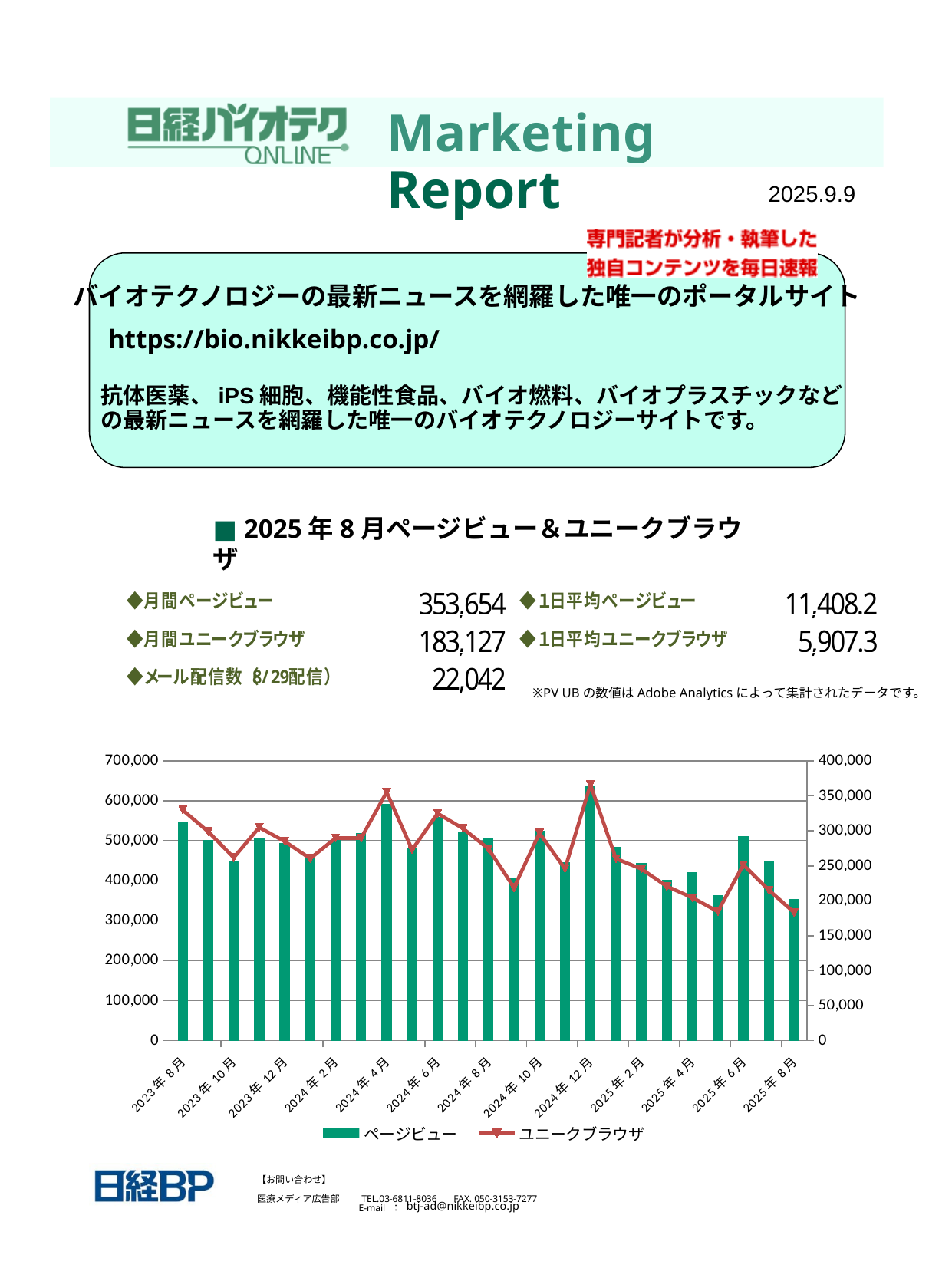
Is the ユニークブラウザ value for 2025年8月 greater or less than 200,000 on the right axis? less Do the ページビュー bars generally rise or fall from 2024年12月 to 2025年5月? fall How many monthly bars are plotted in the chart? 25 Which month has the highest ページビュー bar? 2024年12月 What is the maximum value shown on the left vertical axis? 700,000 Which month has the larger ページビュー bar, 2024年4月 or 2023年10月? 2024年4月 How many series does the chart legend list? 2 Which month has the highest point on the ユニークブラウザ line? 2024年12月 Is the ページビュー bar for 2025年8月 greater or less than 400,000? less What are the two series named in the chart legend? ページビュー and ユニークブラウザ Is the ページビュー bar for 2024年12月 greater or less than 600,000? greater What kind of chart is shown on the slide? A combined bar and line chart